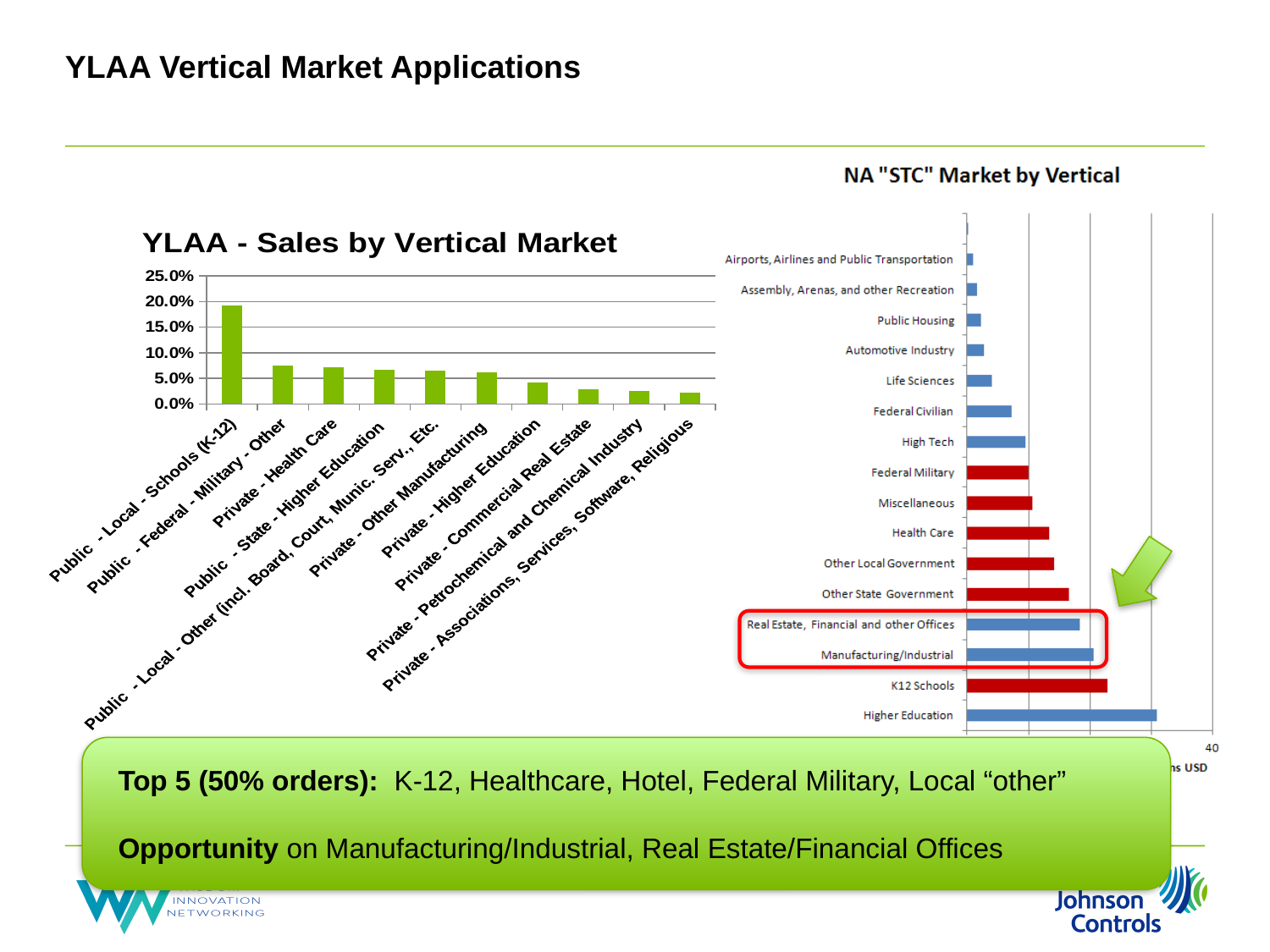
In "YLAA - Sales by Vertical Market", is the value for Public - Local - Schools (K-12) greater or less than 15.0%? greater In "NA "STC" Market by Vertical", which category has the longest bar? Higher Education What type of chart is "YLAA - Sales by Vertical Market"? Bar chart In "YLAA - Sales by Vertical Market", is the value for Private - Health Care greater or less than 5.0%? greater What type of chart is "NA "STC" Market by Vertical"? Bar chart In "YLAA - Sales by Vertical Market", is the value for Public - Federal - Military - Other greater or less than 10.0%? less How many categories are shown in "YLAA - Sales by Vertical Market"? 10 In "YLAA - Sales by Vertical Market", do the values generally rise or fall from left to right along the x axis? Fall In "NA "STC" Market by Vertical", which is larger, Health Care or High Tech? Health Care In "YLAA - Sales by Vertical Market", which category has the highest value? Public - Local - Schools (K-12) In "NA "STC" Market by Vertical", which two categories are outlined with a red box? Real Estate, Financial and other Offices; Manufacturing/Industrial In "YLAA - Sales by Vertical Market", which category has the lowest value? Private - Associations, Services, Software, Religious